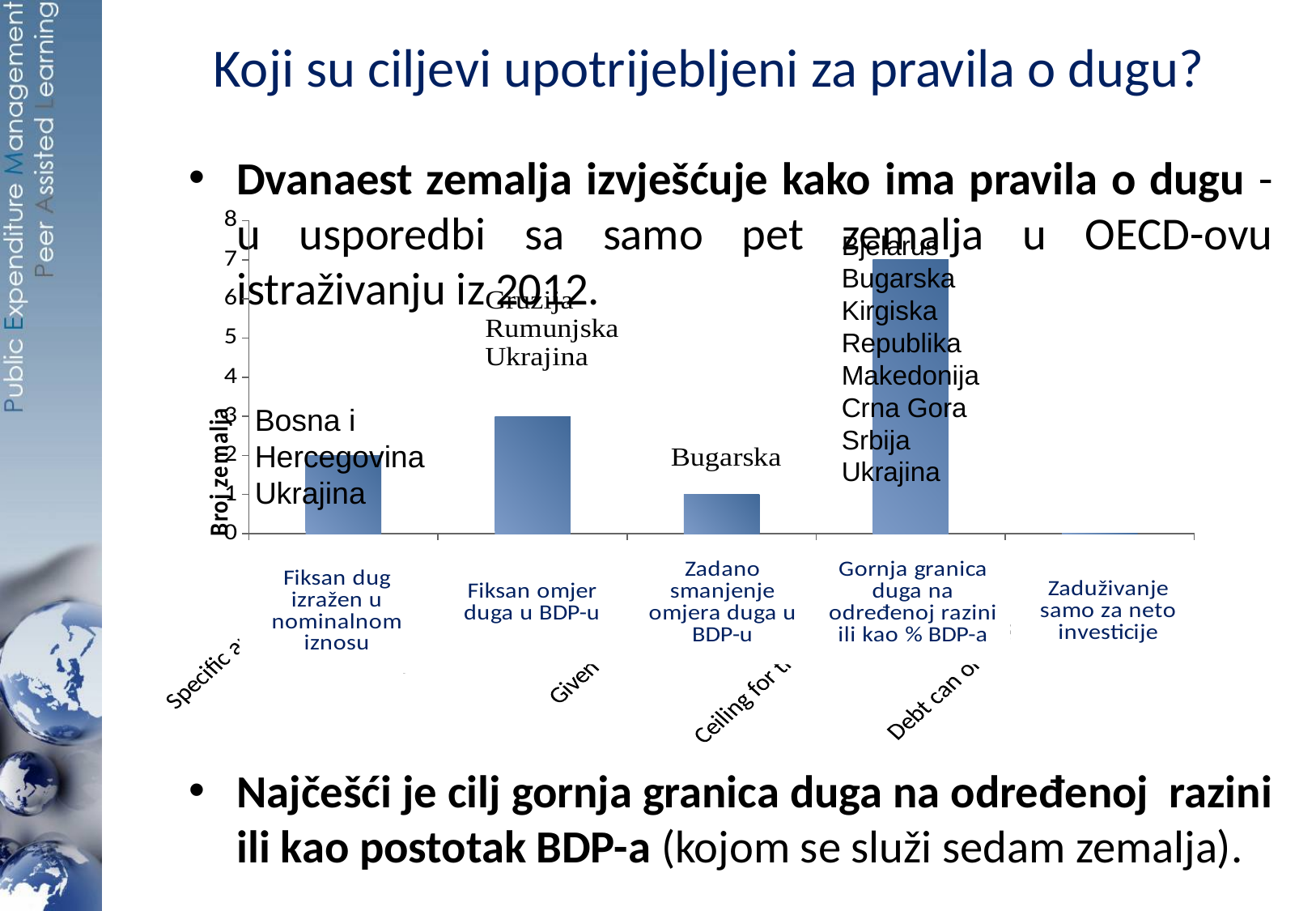
Is the value for 'Gornja granica duga na određenoj razini ili kao % BDP-a' greater or less than 5? greater Which is larger: the bar for 'Fiksan omjer duga u BDP-u' or the bar for 'Zadano smanjenje omjera duga u BDP-u'? Fiksan omjer duga u BDP-u What is the value (Broj zemalja) for 'Zadano smanjenje omjera duga u BDP-u'? 1 Which category has the highest bar in the chart? Gornja granica duga na određenoj razini ili kao % BDP-a What kind of chart is shown on the slide? bar chart What is the value (Broj zemalja) for 'Gornja granica duga na određenoj razini ili kao % BDP-a'? 7 How many categories are shown on the x axis of the chart? 5 What is the value (Broj zemalja) for 'Fiksan dug izražen u nominalnom iznosu'? 2 What is the label of the vertical axis of the chart? Broj zemalja What is the difference between the value for 'Gornja granica duga na određenoj razini ili kao % BDP-a' and the value for 'Fiksan omjer duga u BDP-u'? 4 Which category has the lowest bar in the chart? Zaduživanje samo za neto investicije What is the value (Broj zemalja) for 'Fiksan omjer duga u BDP-u'? 3